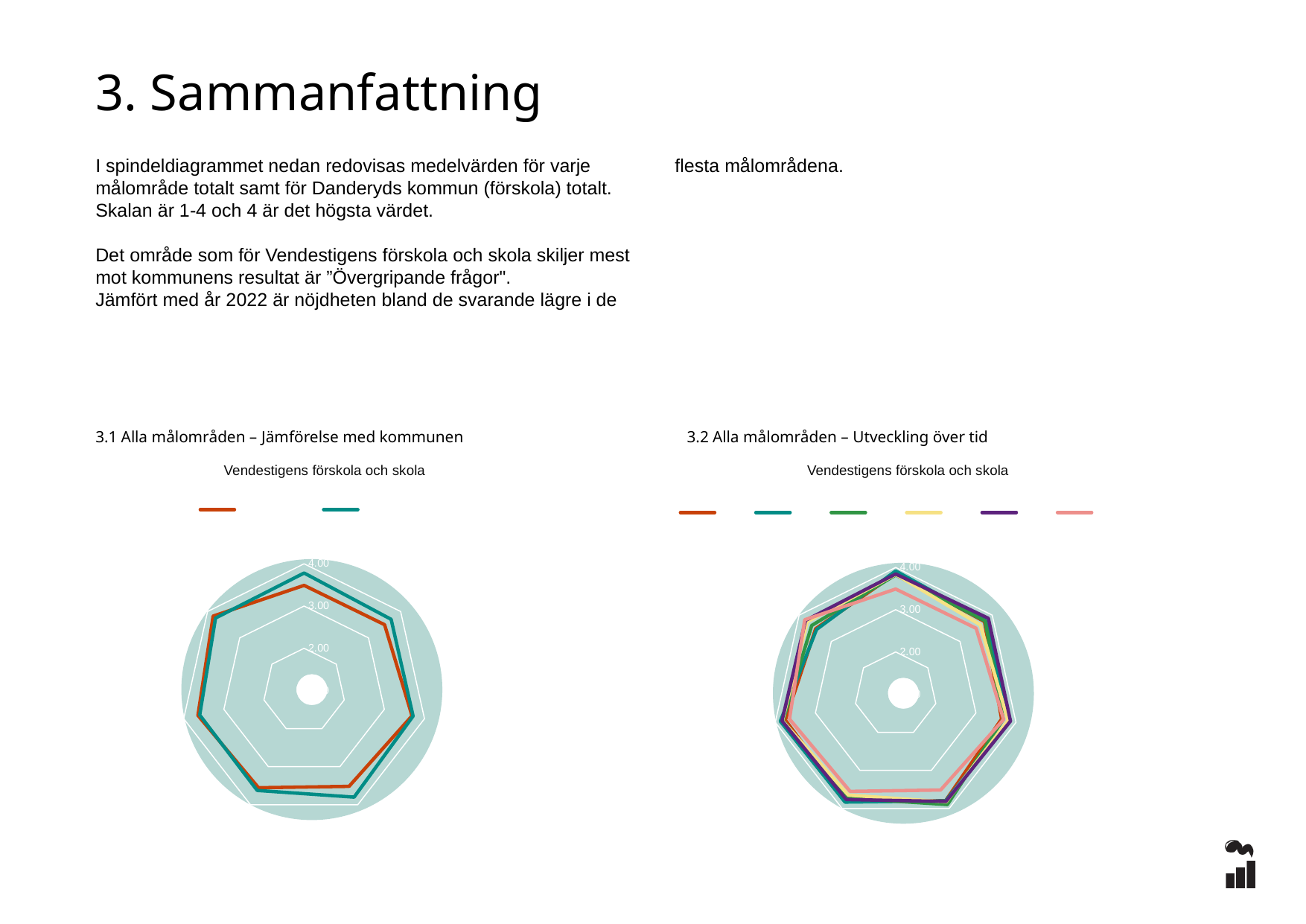
What is the title shown above the left chart (3.1 Alla målområden – Jämförelse med kommunen)? Vendestigens förskola och skola How many axes (categories) does the right chart (3.2 Alla målområden – Utveckling över tid) have? 7 How many series does the legend of the right chart (3.2 Alla målområden – Utveckling över tid) list? 6 What kind of chart is the chart under "3.2 Alla målområden – Utveckling över tid"? Radar chart In the right chart (3.2 Alla målområden – Utveckling över tid), are all plotted values greater or less than 2.00? greater What is the highest axis tick value labelled on the right chart (3.2 Alla målområden – Utveckling över tid)? 4.00 How many axes (categories) does the left chart (3.1 Alla målområden – Jämförelse med kommunen) have? 7 How many series does the legend of the left chart (3.1 Alla målområden – Jämförelse med kommunen) list? 2 What kind of chart is the chart under "3.1 Alla målområden – Jämförelse med kommunen"? Radar chart In the left chart (3.1 Alla målområden – Jämförelse med kommunen), are all plotted values greater or less than 2.00? greater